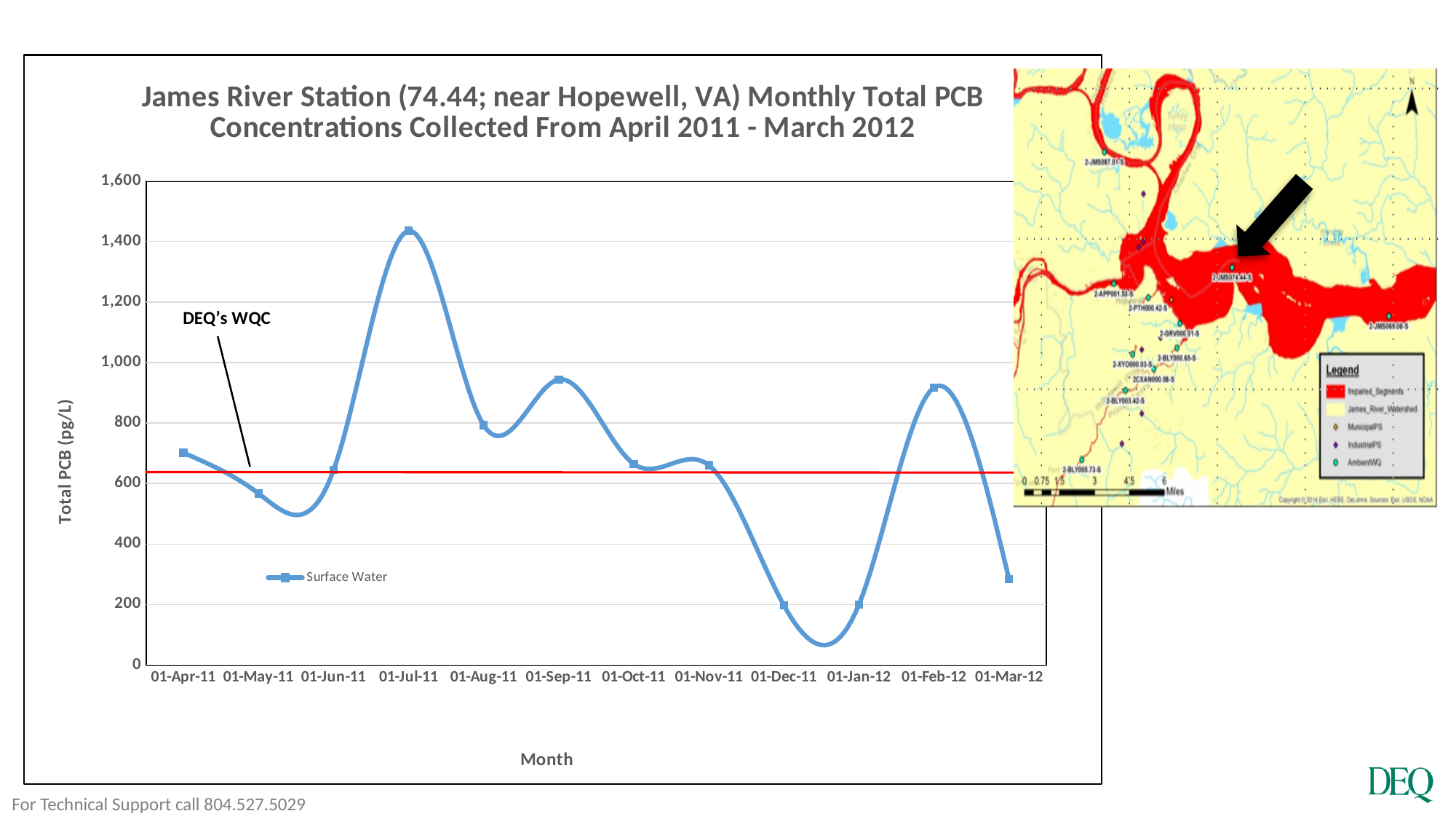
Is the value for 01-Mar-12 greater or less than 400? less Is the value for 01-Dec-11 greater or less than 400? less Is the value for 01-Apr-11 greater or less than 600? greater Which month has the highest Total PCB concentration? 01-Jul-11 Which is larger, the value for 01-Jul-11 or the value for 01-Sep-11? 01-Jul-11 How many monthly data points are plotted on the chart? 12 What is the label of the y axis? Total PCB (pg/L) How many series does the chart legend list? 1 Do the values rise or fall from 01-Nov-11 to 01-Dec-11? fall What kind of chart is shown on the slide? line chart What does the red horizontal line on the chart represent? DEQ's WQC